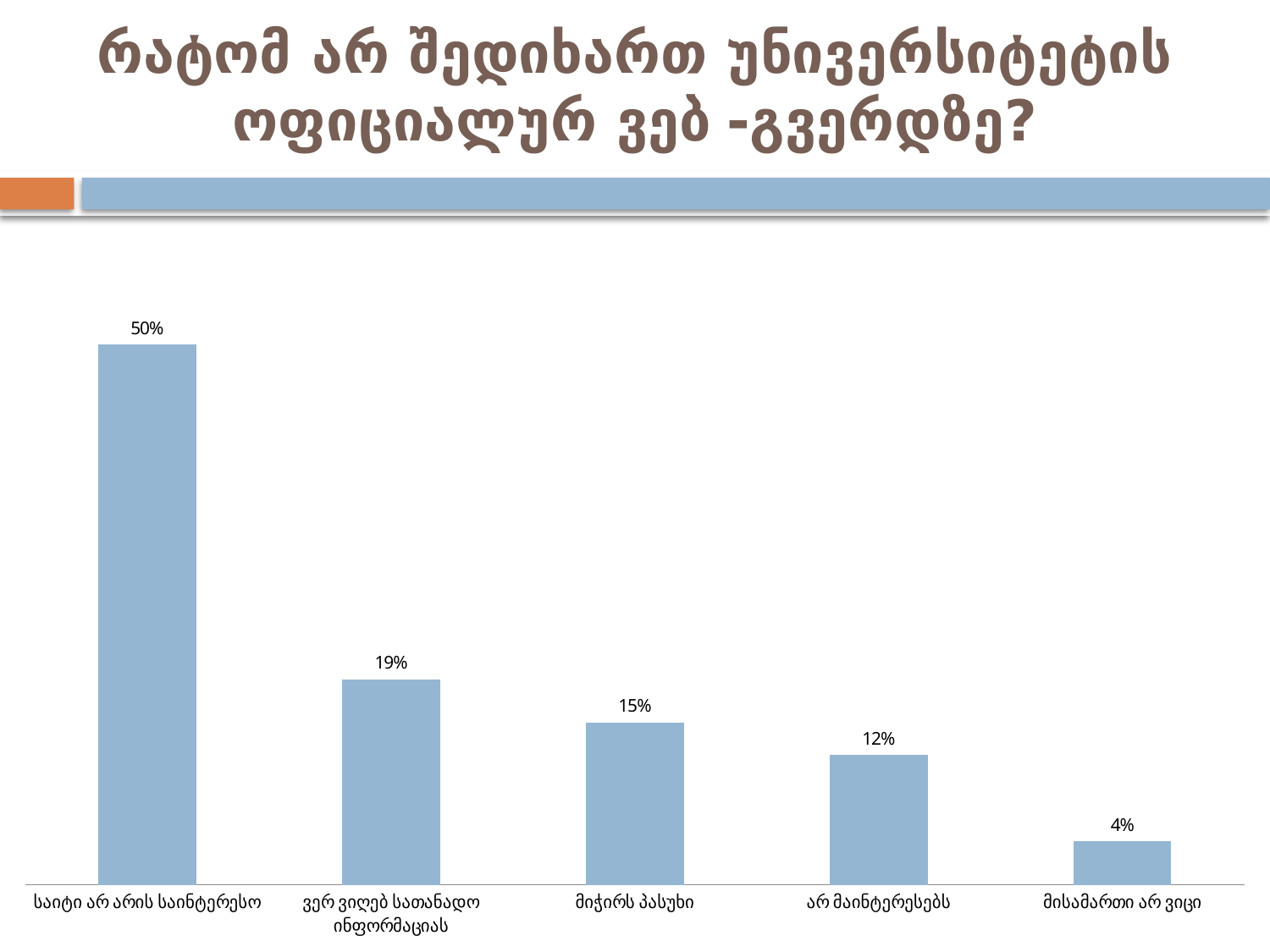
How many categories are shown in the chart? 5 Which category has the highest value? საიტი არ არის საინტერესო What is the value for "მისამართი არ ვიცი"? 4% What kind of chart is shown on the slide? Bar chart What is the difference between the values for "საიტი არ არის საინტერესო" and "ვერ ვიღებ სათანადო ინფორმაციას"? 31% What is the value for "ვერ ვიღებ სათანადო ინფორმაციას"? 19% Do the values rise or fall from left to right along the x axis? Fall What is the value for "მიჭირს პასუხი"? 15% Which category has the lowest value? მისამართი არ ვიცი What is the value for "საიტი არ არის საინტერესო"? 50% What is the value for "არ მაინტერესებს"? 12% Which is larger, the value for "მიჭირს პასუხი" or the value for "არ მაინტერესებს"? მიჭირს პასუხი